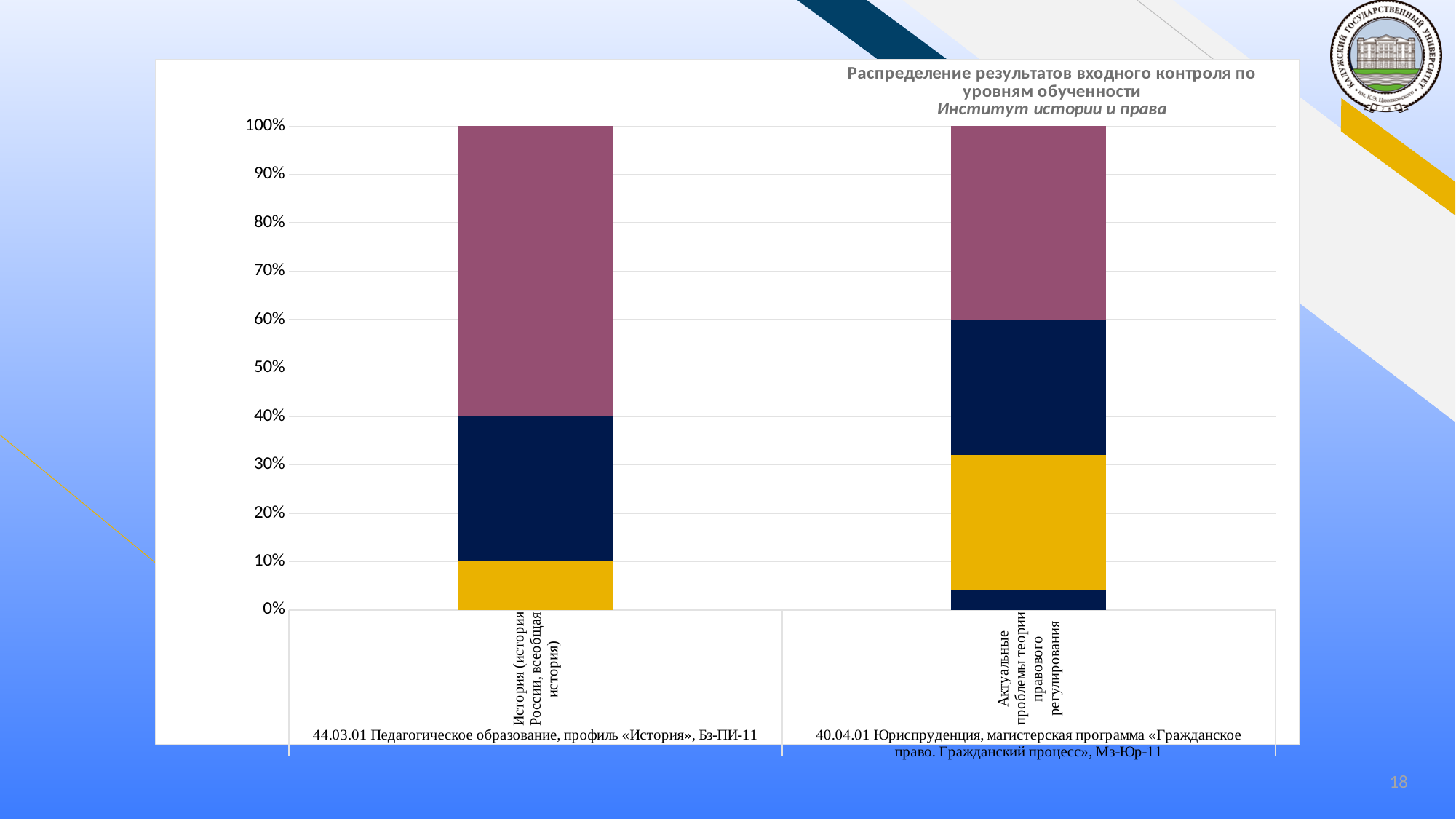
What is the total of the stacked bar for 40.04.01 Юриспруденция, магистерская программа «Гражданское право. Гражданский процесс», Мз-Юр-11? 100% In the bar for 44.03.01 Педагогическое образование (Бз-ПИ-11), at what percentage does the bottom yellow segment end? 10% In the bar for 44.03.01 Педагогическое образование (Бз-ПИ-11), at what percentage does the top mauve segment begin? 40% In the bar for 40.04.01 Юриспруденция (Мз-Юр-11), is the top of the yellow segment greater or less than 40%? less In the bar for 40.04.01 Юриспруденция (Мз-Юр-11), at what percentage does the top mauve segment begin? 60% Which bar has the larger top (mauve) segment: 44.03.01 Педагогическое образование (Бз-ПИ-11) or 40.04.01 Юриспруденция (Мз-Юр-11)? 44.03.01 Педагогическое образование (Бз-ПИ-11) What kind of chart is shown on the slide? bar chart What is the title of the chart? Распределение результатов входного контроля по уровням обученности Which bar has the larger yellow segment: 44.03.01 Педагогическое образование (Бз-ПИ-11) or 40.04.01 Юриспруденция (Мз-Юр-11)? 40.04.01 Юриспруденция (Мз-Юр-11) Which institute is named in the chart's subtitle? Институт истории и права How many bars (categories) does the chart show? 2 What is the total of the stacked bar for 44.03.01 Педагогическое образование, профиль «История», Бз-ПИ-11? 100%